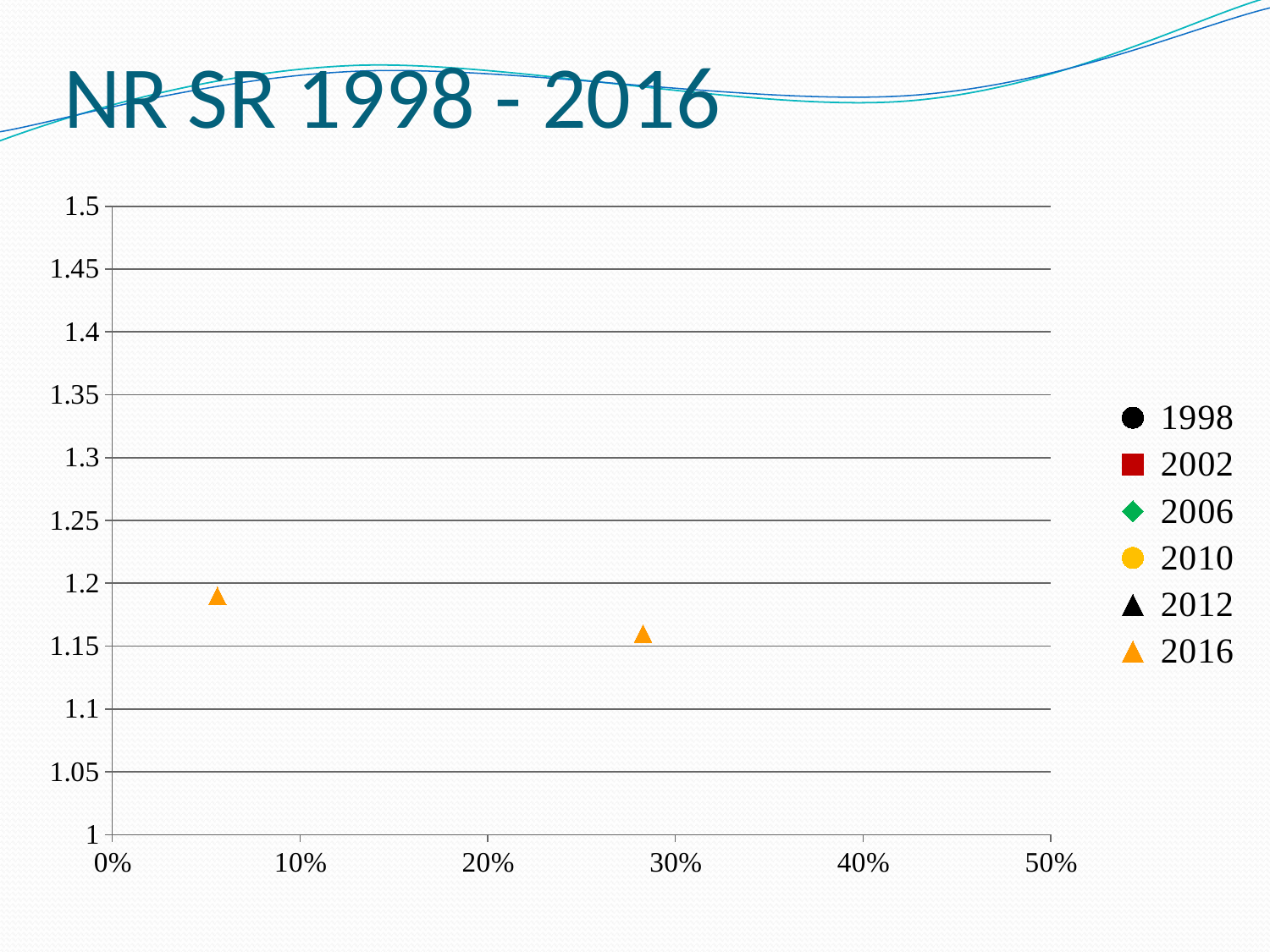
Which series do the plotted points belong to? 2016 Is the vertical value of the rightmost 2016 point greater or less than 1.2? less How many data points are plotted on the chart? 2 Is the horizontal value of the leftmost 2016 point greater or less than 10%? less Is the vertical value of the leftmost 2016 point greater or less than 1.15? greater What kind of chart is shown on the slide? scatter chart What is the title of the chart? NR SR 1998 - 2016 How many series does the legend list? 6 Which of the two 2016 points has the higher vertical value, the one near 6% or the one near 28%? the one near 6% Do the plotted values rise or fall as the horizontal percentage increases? fall